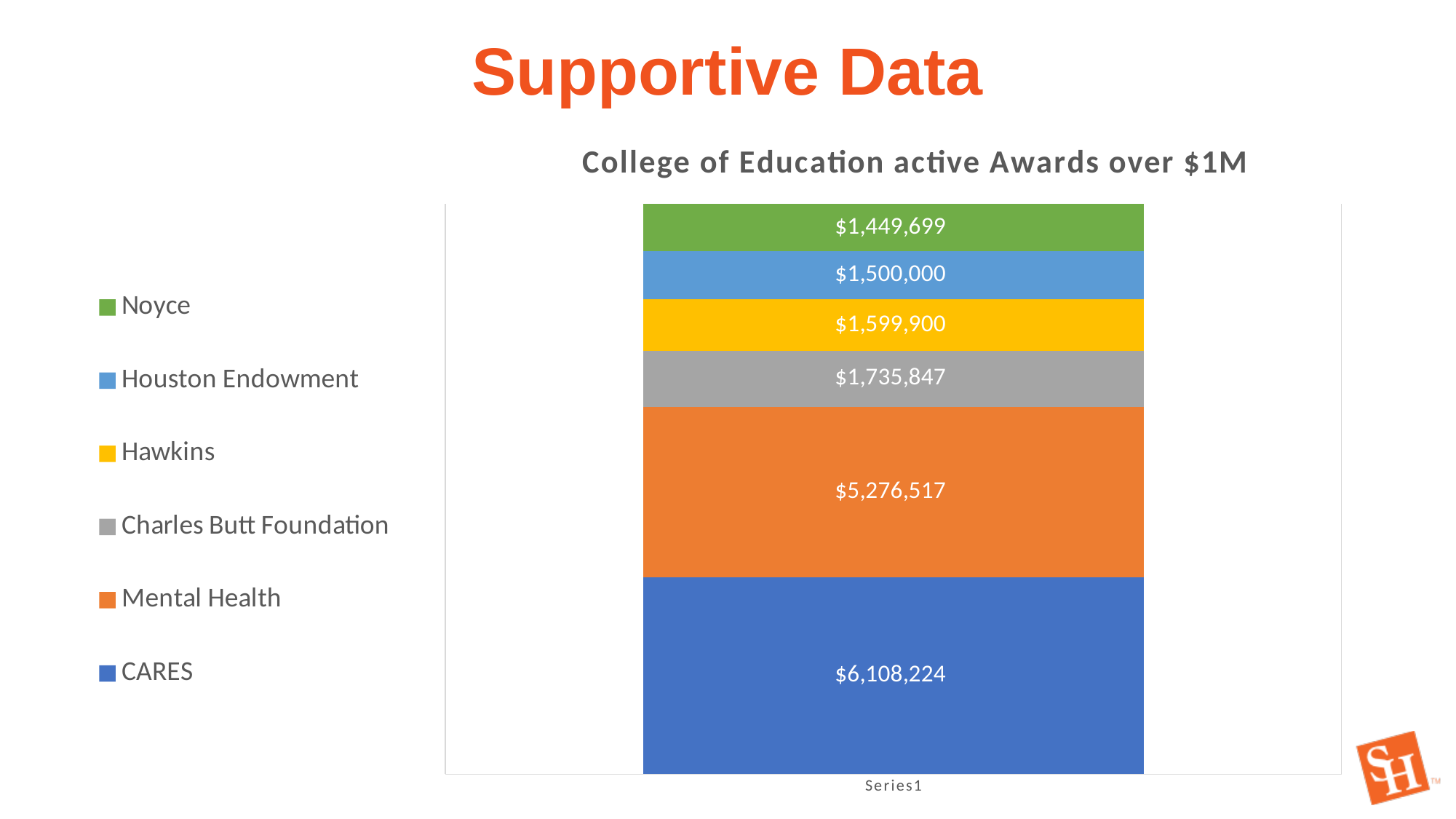
What is the difference between the CARES and Mental Health values? $831,707 What is the value of the Mental Health segment? $5,276,517 What is the value of the CARES segment in the chart? $6,108,224 What is the value shown for Charles Butt Foundation? $1,735,847 Which award has the smallest value in the chart? Noyce What is the value shown for Noyce? $1,449,699 Which award has the largest value in the chart? CARES How many entries does the legend list? 6 What is the value shown for Hawkins? $1,599,900 What is the total of all segments in the stacked bar? $17,670,187 What type of chart is shown on the slide? Stacked bar chart Which is larger, the Houston Endowment value or the Hawkins value? Hawkins